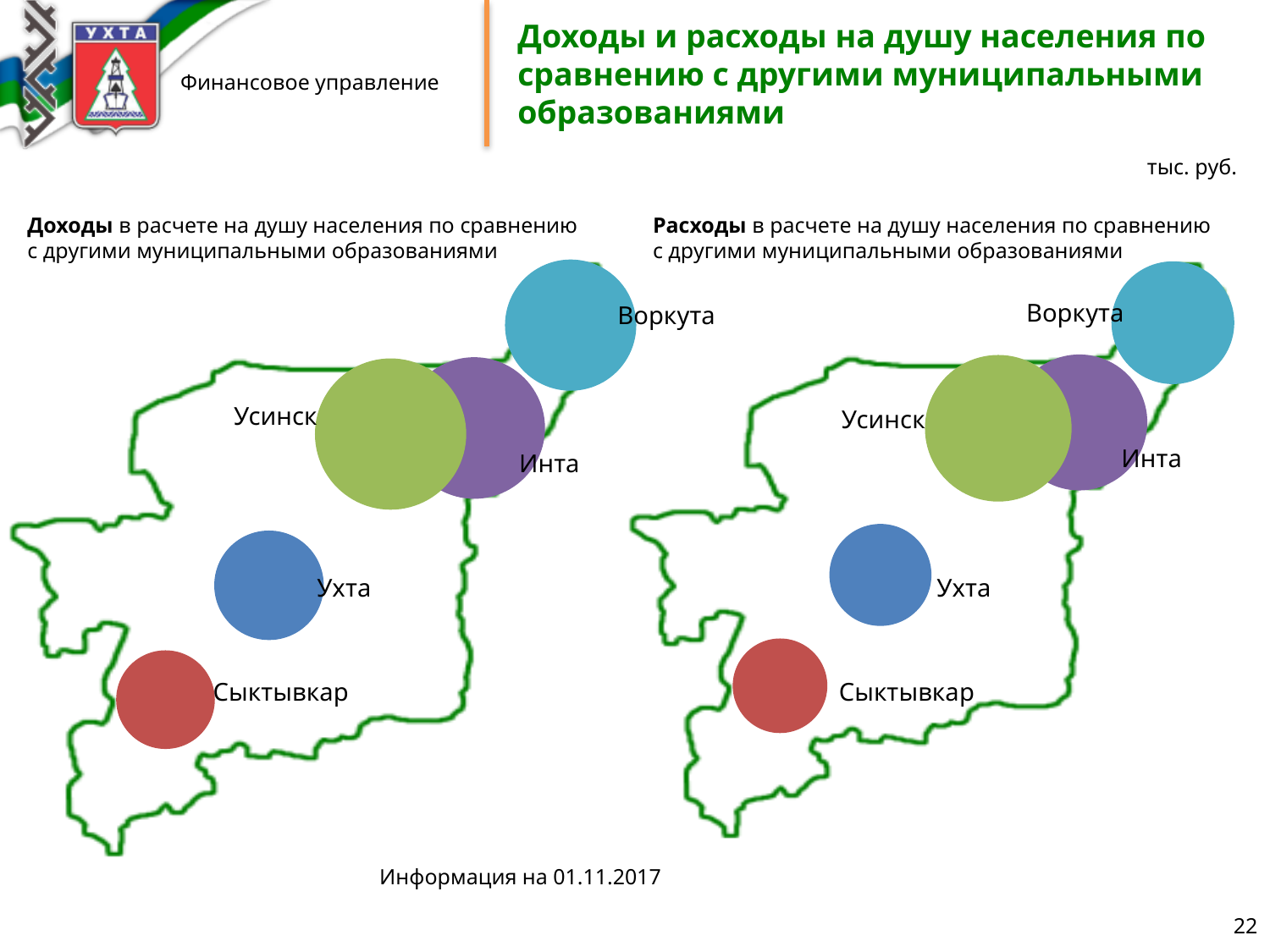
On the left-hand chart (Доходы), which municipality has the largest bubble? Усинск On the left-hand chart (Доходы), which bubble is larger: Ухта or Воркута? Воркута On the right-hand chart (Расходы), which bubble is larger: Усинск or Ухта? Усинск On the left-hand chart (Доходы), which bubble is larger: Ухта or Усинск? Усинск How many municipalities are shown as bubbles on the left-hand chart (Доходы)? 5 What colour is the bubble for Ухта on both charts? blue What kind of chart is used on the left-hand chart (Доходы в расчете на душу населения)? bubble chart How many municipalities are shown as bubbles on the right-hand chart (Расходы)? 5 What unit of measurement is stated for the charts on the slide? тыс. руб. On the right-hand chart (Расходы), which municipality has the largest bubble? Усинск